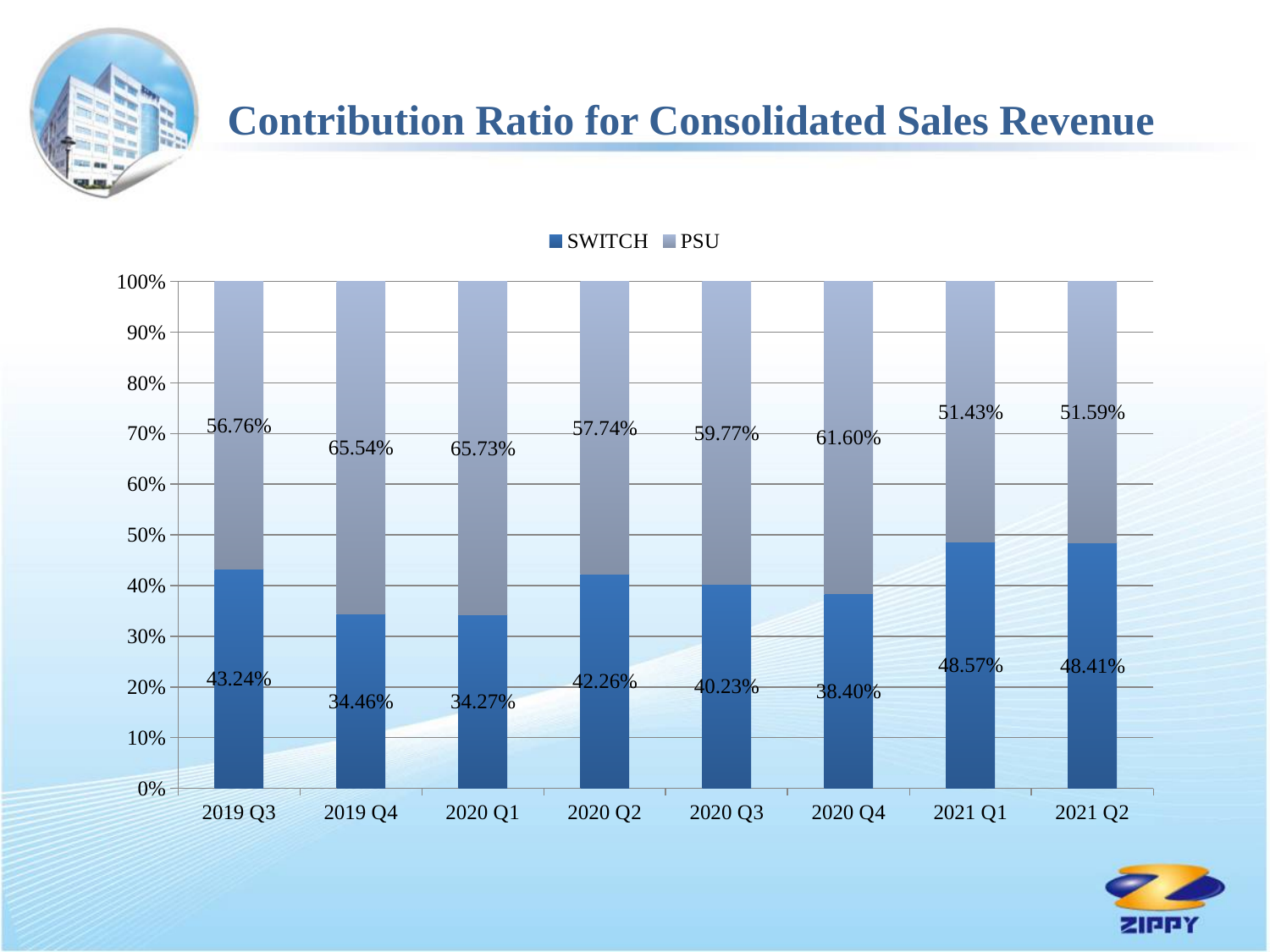
Which quarter has the highest SWITCH value? 2021 Q1 What is the SWITCH value for 2019 Q3? 43.24% How many quarters are shown on the x axis? 8 What is the difference between the PSU and SWITCH values in 2020 Q4? 23.20% What is the title of the chart? Contribution Ratio for Consolidated Sales Revenue What is the PSU value for 2020 Q4? 61.60% What kind of chart is shown on the slide? Stacked bar chart Which quarter has the lowest SWITCH value? 2020 Q1 What is the SWITCH value for 2021 Q2? 48.41% How many series does the legend list? 2 Which is larger in 2020 Q2, the SWITCH value or the PSU value? PSU Which quarter has the highest PSU value? 2020 Q1